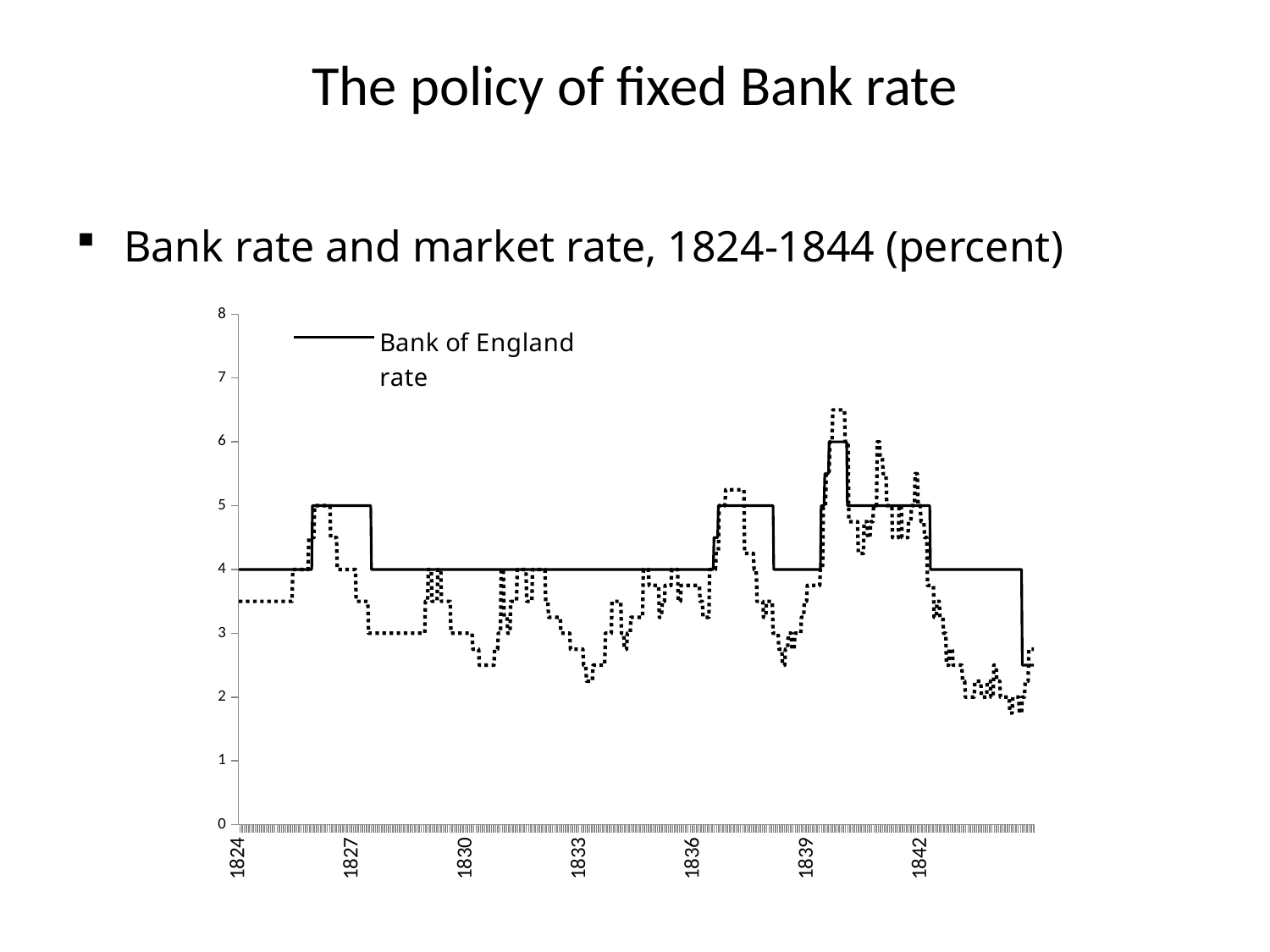
What kind of chart is shown on the slide? line chart How many series does the chart legend list? 1 What is the Bank of England rate at 1833? 4 What is the Bank of England rate at the start of the chart in 1824? 4 How many year labels are shown on the x axis? 7 At 1833, which is larger: the solid Bank of England rate line or the dotted line? Bank of England rate What is the highest value reached by the Bank of England rate (solid line)? 6 What series name appears in the chart legend? Bank of England rate What is the Bank of England rate at 1827? 5 Is the value of the dotted line at 1833 greater or less than 3? less